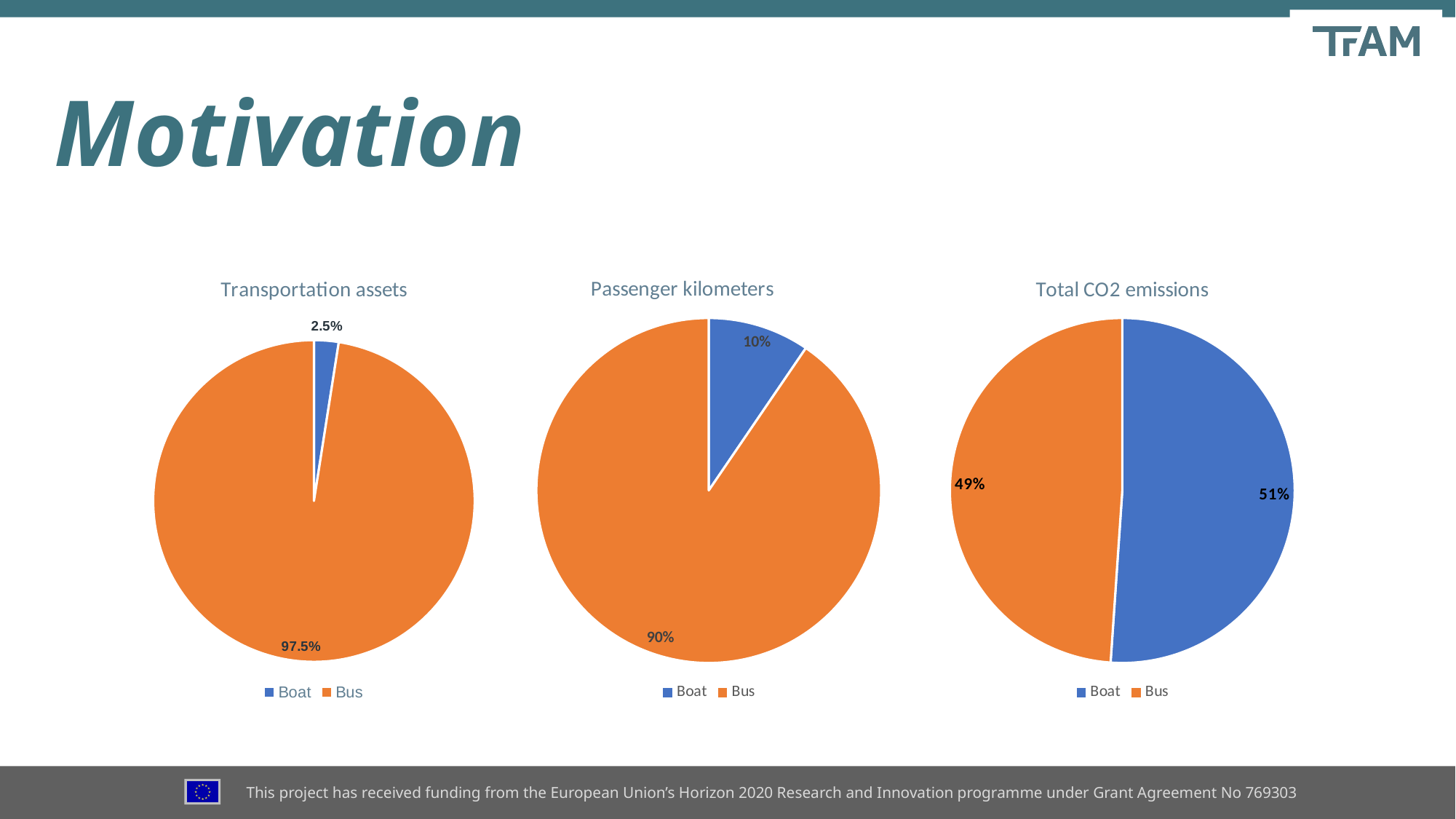
How many categories does the legend of the 'Transportation assets' chart list? 2 In the 'Total CO2 emissions' chart, what share does Bus have? 49% In the 'Total CO2 emissions' chart, which category has the largest slice? Boat In the 'Transportation assets' chart, what share does Boat have? 2.5% What kind of chart is the 'Total CO2 emissions' chart? Pie chart In the 'Transportation assets' chart, what share does Bus have? 97.5% In the 'Passenger kilometers' chart, what share does Bus have? 90% In the 'Passenger kilometers' chart, which is larger, Boat or Bus? Bus In the 'Passenger kilometers' chart, what share does Boat have? 10% In the 'Passenger kilometers' chart, which category has the smallest slice? Boat In the 'Total CO2 emissions' chart, what share does Boat have? 51% In the 'Transportation assets' chart, what is the difference between the Bus and Boat shares? 95%